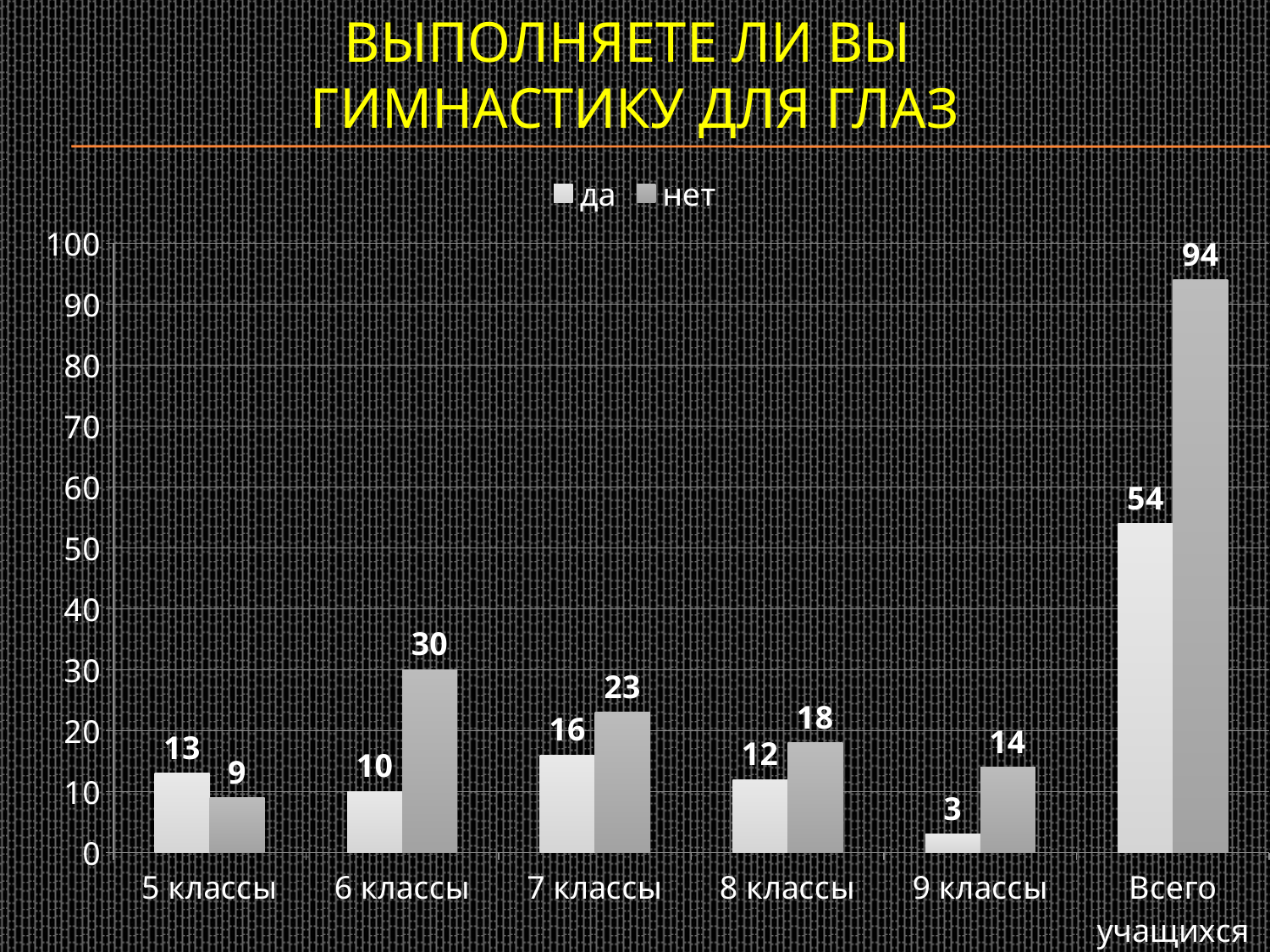
What is the value for "нет" in the "Всего учащихся" category? 94 What is the difference between "нет" and "да" in the "Всего учащихся" category? 40 Among the class categories (excluding "Всего учащихся"), which has the highest value for "нет"? 6 классы Which category has the lowest value for "да"? 9 классы What kind of chart is shown on the slide? bar chart How many series does the legend list? 2 What is the value for "нет" in the "6 классы" category? 30 What is the title of the chart? ВЫПОЛНЯЕТЕ ЛИ ВЫ ГИМНАСТИКУ ДЛЯ ГЛАЗ In the "5 классы" category, which is larger, "да" or "нет"? да Is the value for "нет" in "7 классы" greater or less than 20? greater How many categories are shown on the x axis? 6 What is the value for "да" in the "5 классы" category? 13